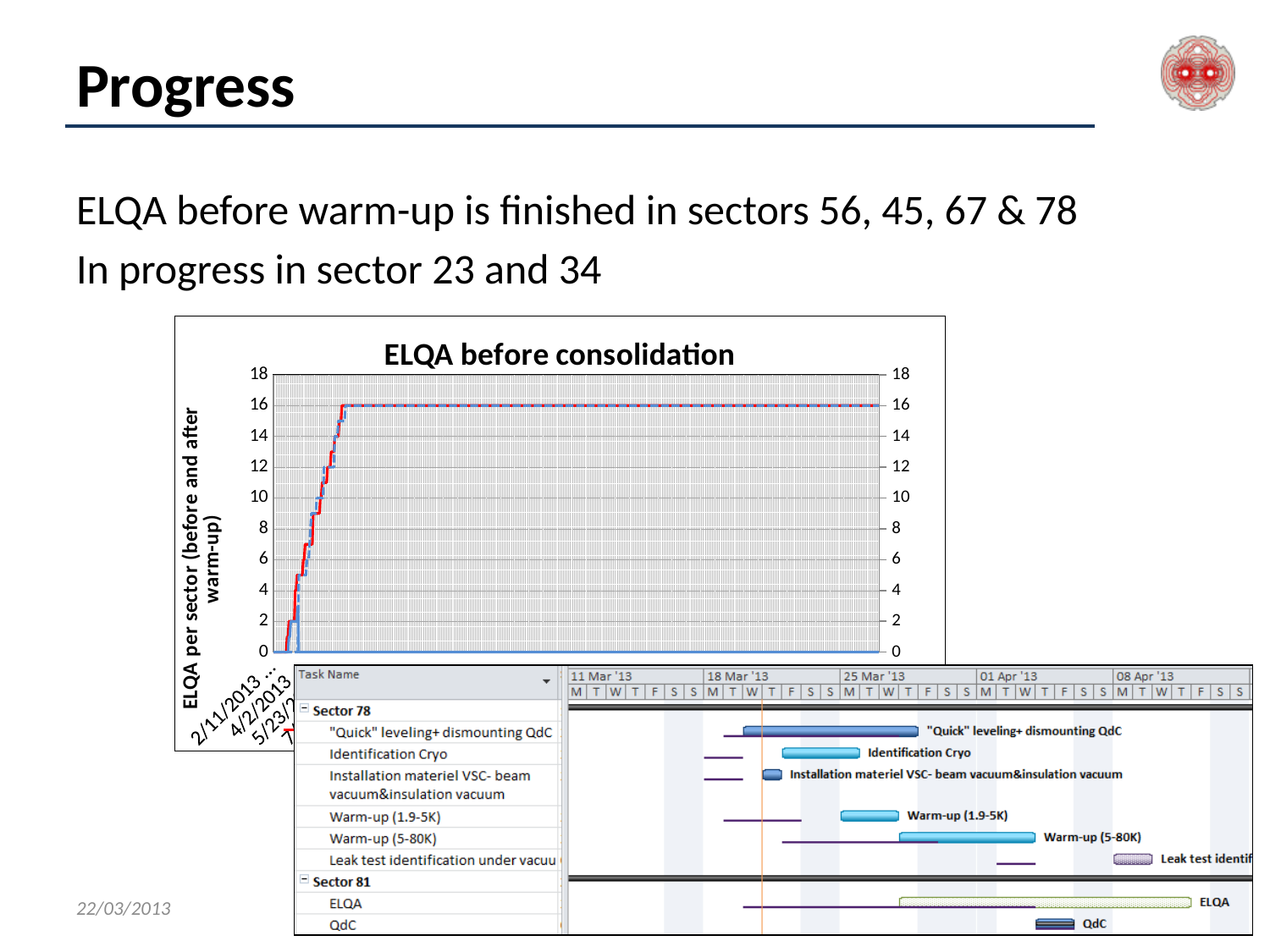
In the 'ELQA before consolidation' chart, at what value do the lines level off and stay flat? 16 What kind of chart is the 'ELQA before consolidation' chart? line chart In the 'ELQA before consolidation' chart, what value do the lines start at on the left of the x axis? 0 What is the title of the chart on the slide? ELQA before consolidation What is the label of the vertical axis of the 'ELQA before consolidation' chart? ELQA per sector (before and after warm-up) How many lines are plotted in the 'ELQA before consolidation' chart? 3 In the 'ELQA before consolidation' chart, do the values rise or fall along the x axis before they level off? rise In the 'ELQA before consolidation' chart, is the final plateau value greater or less than 18? less In the 'ELQA before consolidation' chart, is the final plateau value greater or less than 14? greater